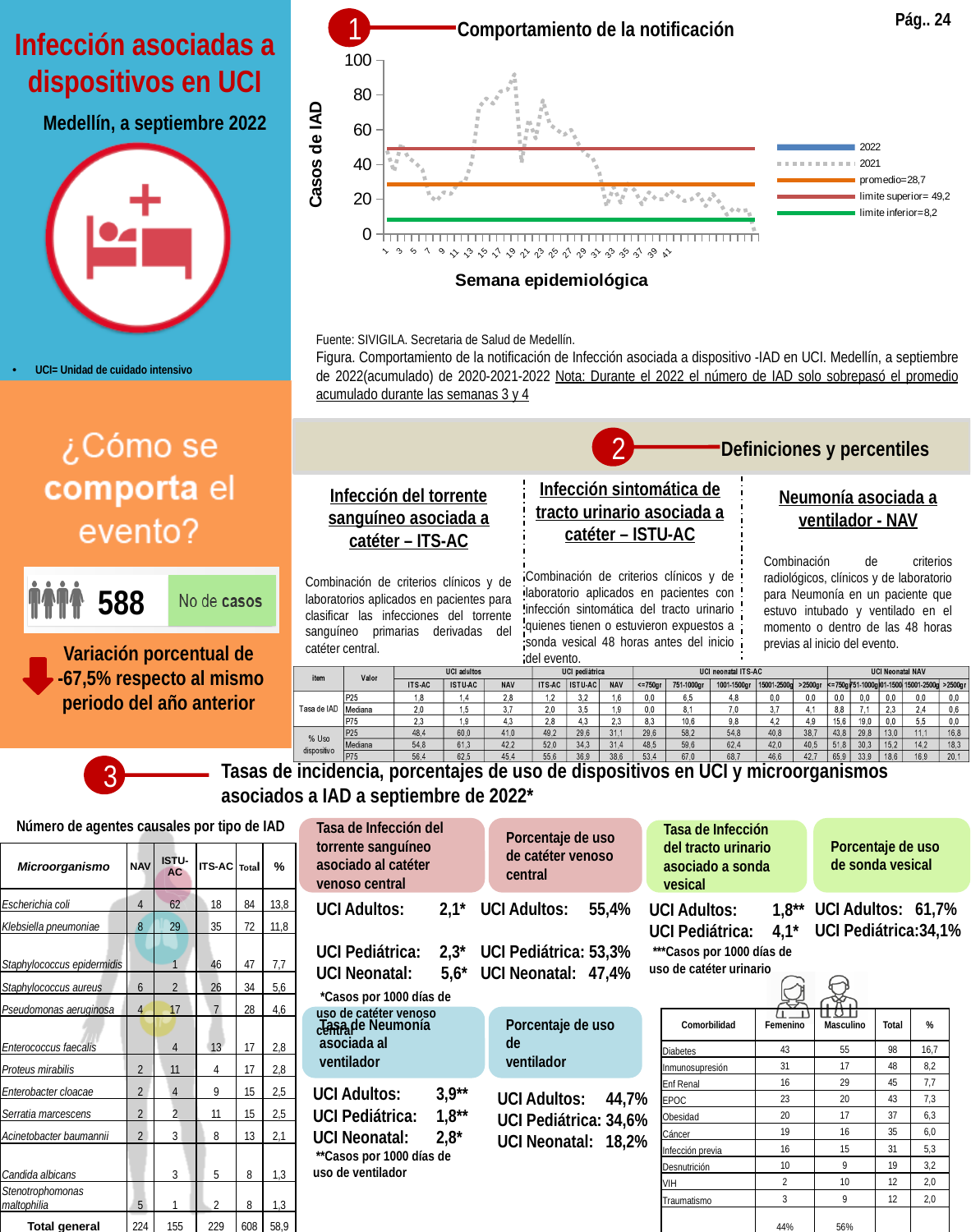
How many series does the legend of the 'Comportamiento de la notificación' chart list? 5 In the 'Comportamiento de la notificación' chart, which is larger, the limite superior or the promedio? limite superior In the 'Comportamiento de la notificación' chart, which is larger, the promedio or the limite inferior? promedio In the 'Comportamiento de la notificación' chart, what is the value of the promedio line? 28,7 In the 'Comportamiento de la notificación' chart, what is the difference between the limite superior and the limite inferior? 41 What is the y-axis title of the 'Comportamiento de la notificación' chart? Casos de IAD In the 'Comportamiento de la notificación' chart, what is the value of the limite inferior line? 8,2 In the 'Comportamiento de la notificación' chart, is the highest value of the 2021 series greater or less than 80? greater In the 'Comportamiento de la notificación' chart, what is the value of the limite superior line? 49,2 What kind of chart is 'Comportamiento de la notificación'? combination bar and line chart In the 'Comportamiento de la notificación' chart, which series is drawn as a dotted line? 2021